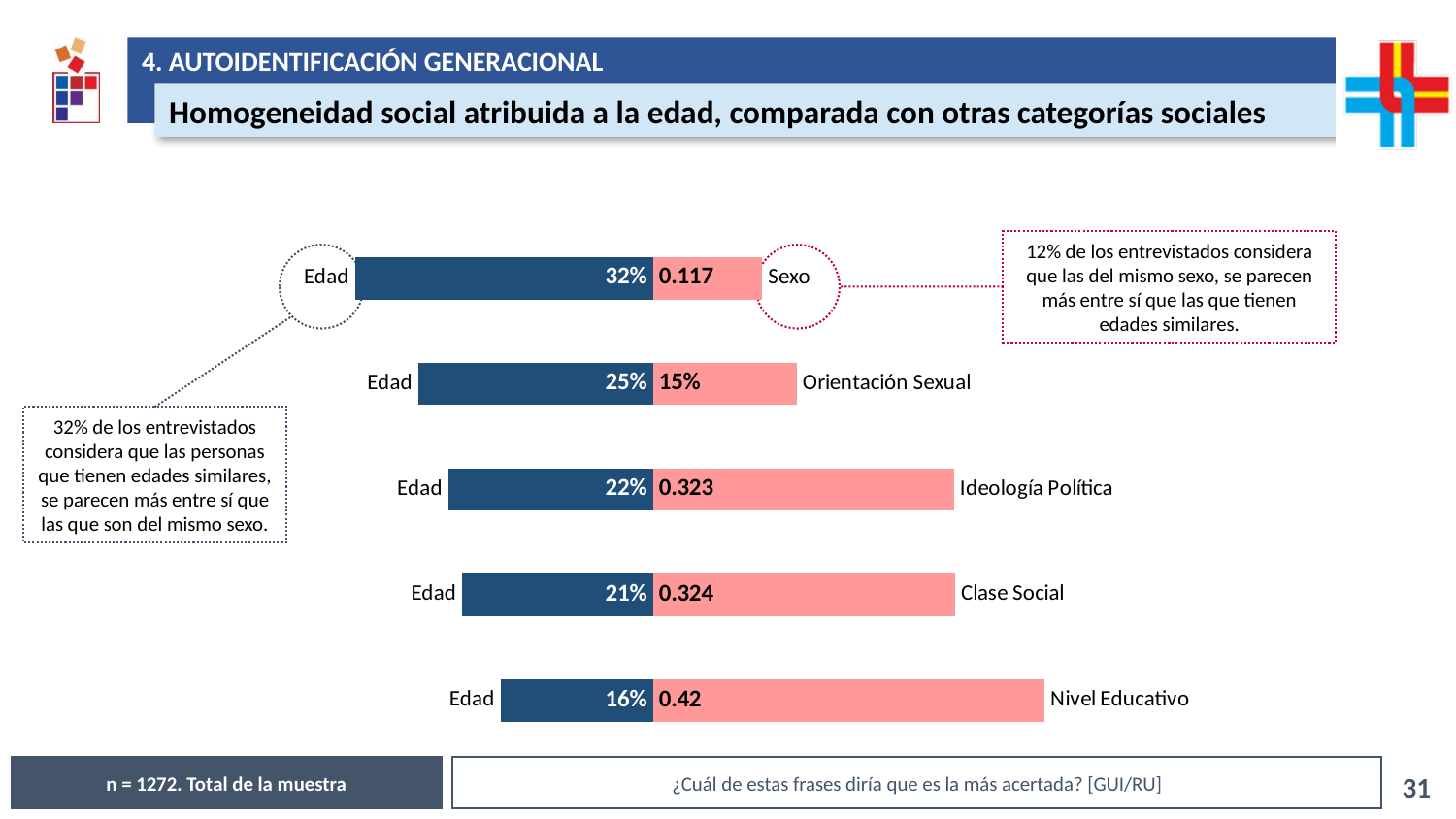
In the Orientación Sexual row, which is larger: the Edad value or the Orientación Sexual value? Edad How many comparison rows (pairs of bars) does the chart show? 5 What percentage of respondents chose Edad when compared with Sexo? 32% What value is printed on the bar for Orientación Sexual? 15% What percentage is shown for Edad in the row comparing it with Clase Social? 21% What value is printed on the pink bar for Sexo? 0.117 What type of chart is shown on the slide? Bar chart In which comparison row does Edad have its highest percentage? Sexo What percentage is shown for Edad in the row comparing it with Orientación Sexual? 25% What is the difference between the Edad percentage in the Sexo row (32%) and the Edad percentage in the Nivel Educativo row (16%)? 16% What value is printed on the bar for Nivel Educativo? 0.42 In which comparison row does Edad have its lowest percentage? Nivel Educativo